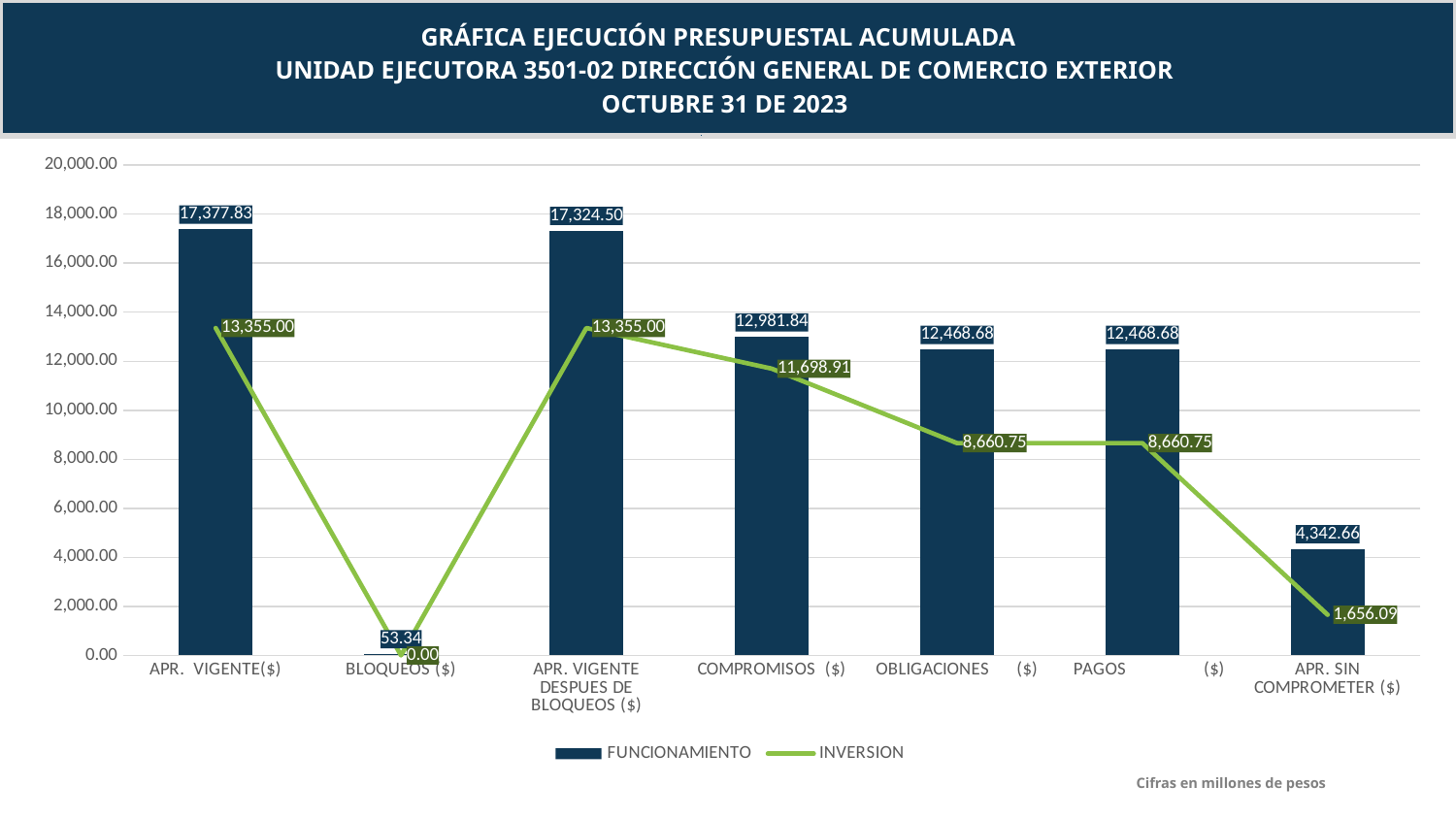
Which category has the highest FUNCIONAMIENTO value? APR. VIGENTE($) Does the INVERSION line rise or fall from COMPROMISOS ($) to APR. SIN COMPROMETER ($)? Fall Which is larger for OBLIGACIONES ($): the FUNCIONAMIENTO value or the INVERSION value? FUNCIONAMIENTO What is the FUNCIONAMIENTO value for APR. VIGENTE($)? 17,377.83 Which series is drawn as a green line? INVERSION What is the FUNCIONAMIENTO value for APR. SIN COMPROMETER ($)? 4,342.66 How many categories are shown on the x axis? 7 How many series does the legend list? 2 What is the INVERSION value for BLOQUEOS ($)? 0.00 Which category has the lowest FUNCIONAMIENTO value? BLOQUEOS ($) What is the difference between the FUNCIONAMIENTO values for APR. VIGENTE($) and APR. VIGENTE DESPUES DE BLOQUEOS ($)? 53.33 What is the INVERSION value for COMPROMISOS ($)? 11,698.91